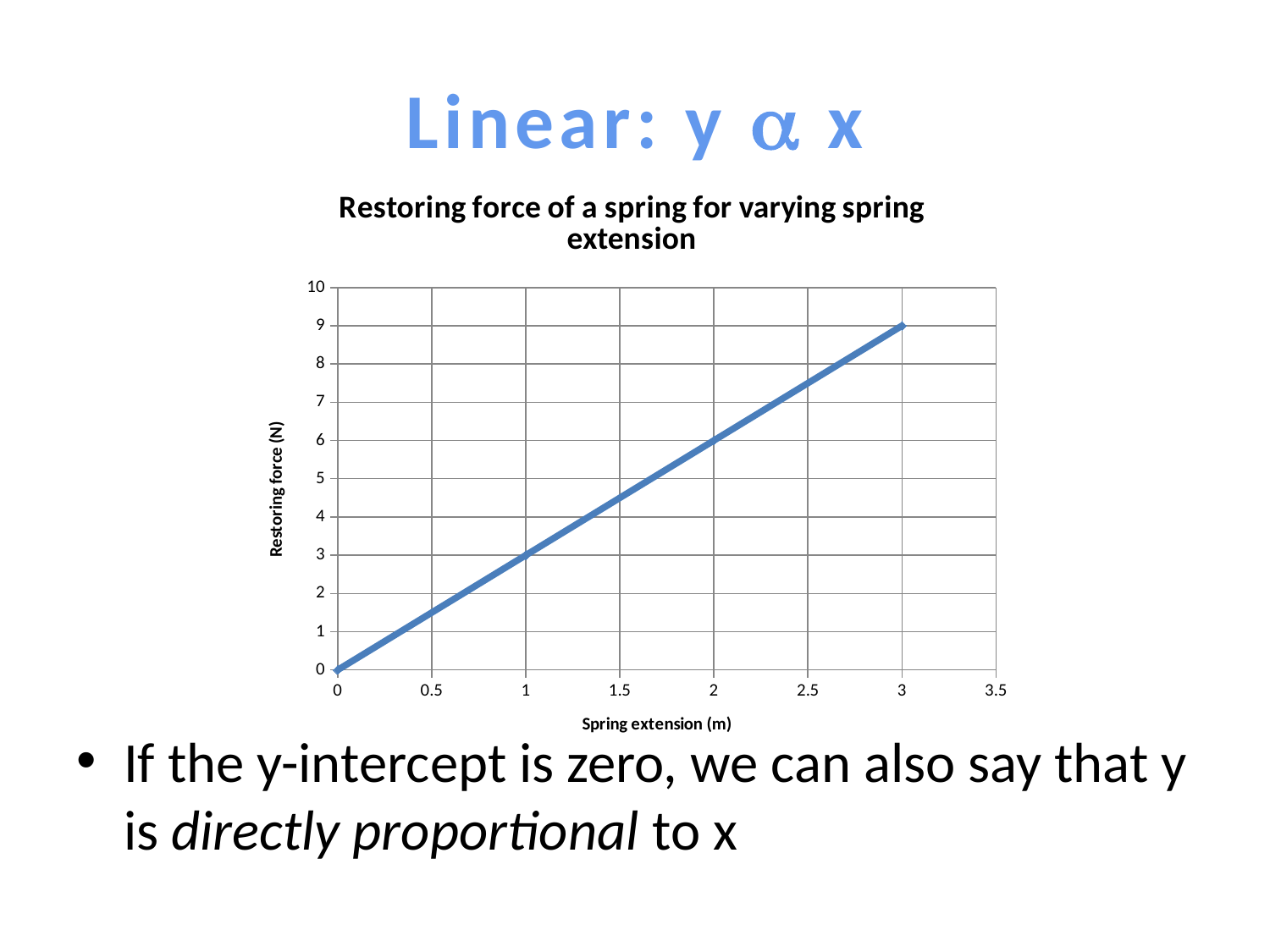
What is the title of the chart? Restoring force of a spring for varying spring extension What is the restoring force at a spring extension of 1 m? 3 What is the restoring force at a spring extension of 0 m? 0 Does the restoring force rise or fall as spring extension increases? rise By how much does the restoring force increase between a spring extension of 0 m and 3 m? 9 Is the restoring force at a spring extension of 2.5 m greater or less than 8? less Is the restoring force at a spring extension of 1.5 m greater or less than 4? greater Which spring extension gives the highest restoring force, 1 m or 3 m? 3 m What kind of chart is shown on the slide? line chart What is the restoring force at a spring extension of 2 m? 6 What is the restoring force at a spring extension of 3 m? 9 What is the label of the y axis? Restoring force (N)